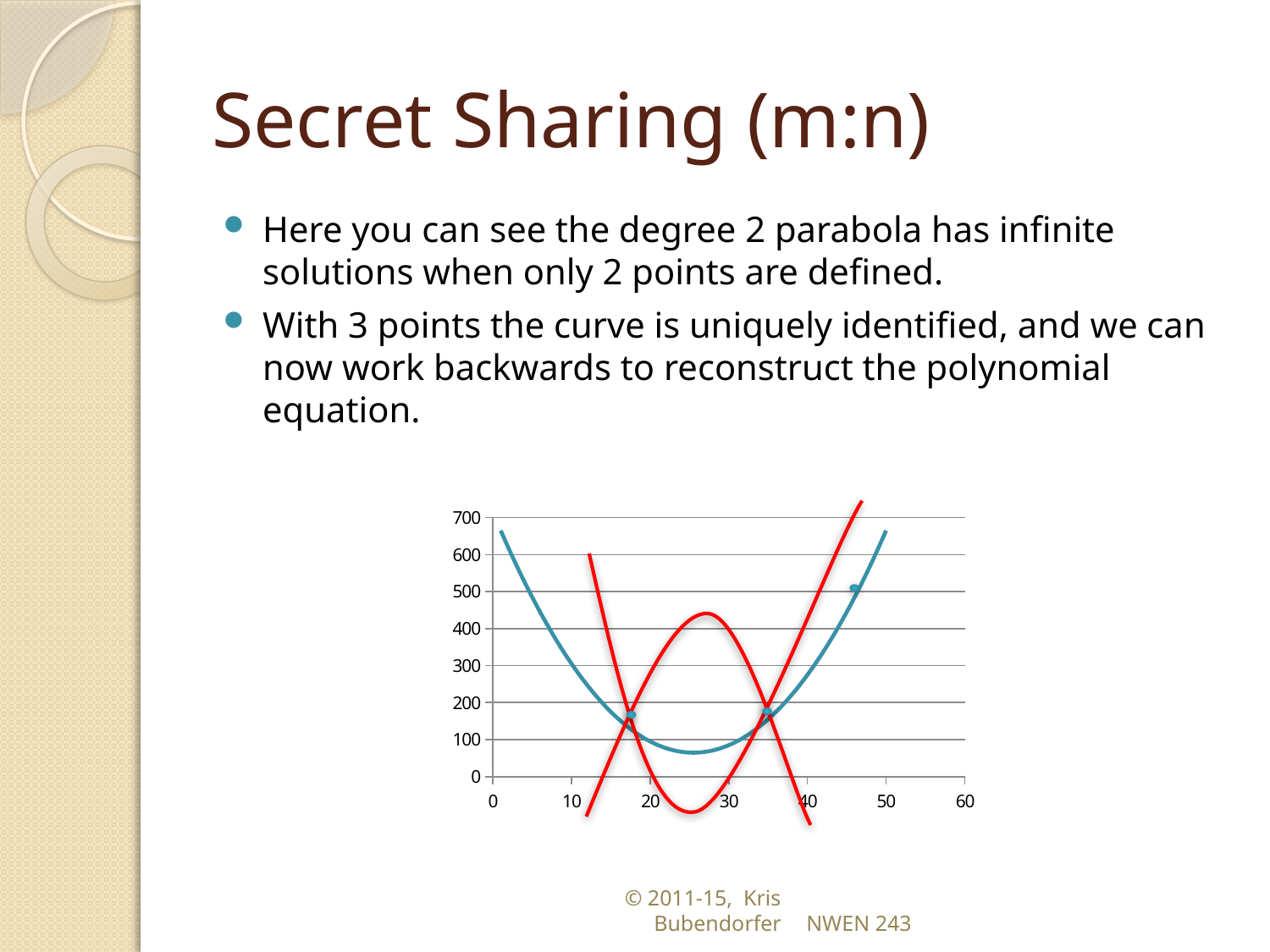
Is the value of the marked point near x = 46 on the blue curve greater or less than 400? greater What kind of chart is shown on the slide? line chart What is the highest value shown on the horizontal axis? 60 How many marked data points are shown on the blue curve? 3 What is the highest value shown on the vertical axis? 700 Is the value of the marked point near x = 35 on the blue curve greater or less than 300? less Is the value of the marked point near x = 17 on the blue curve greater or less than 200? less Does the blue curve rise or fall as x increases from 40 to 50? rise Which of the marked points on the blue curve has the highest value: the one near x = 17, x = 35, or x = 46? the one near x = 46 Does the blue curve rise or fall as x increases from 0 to 10? fall